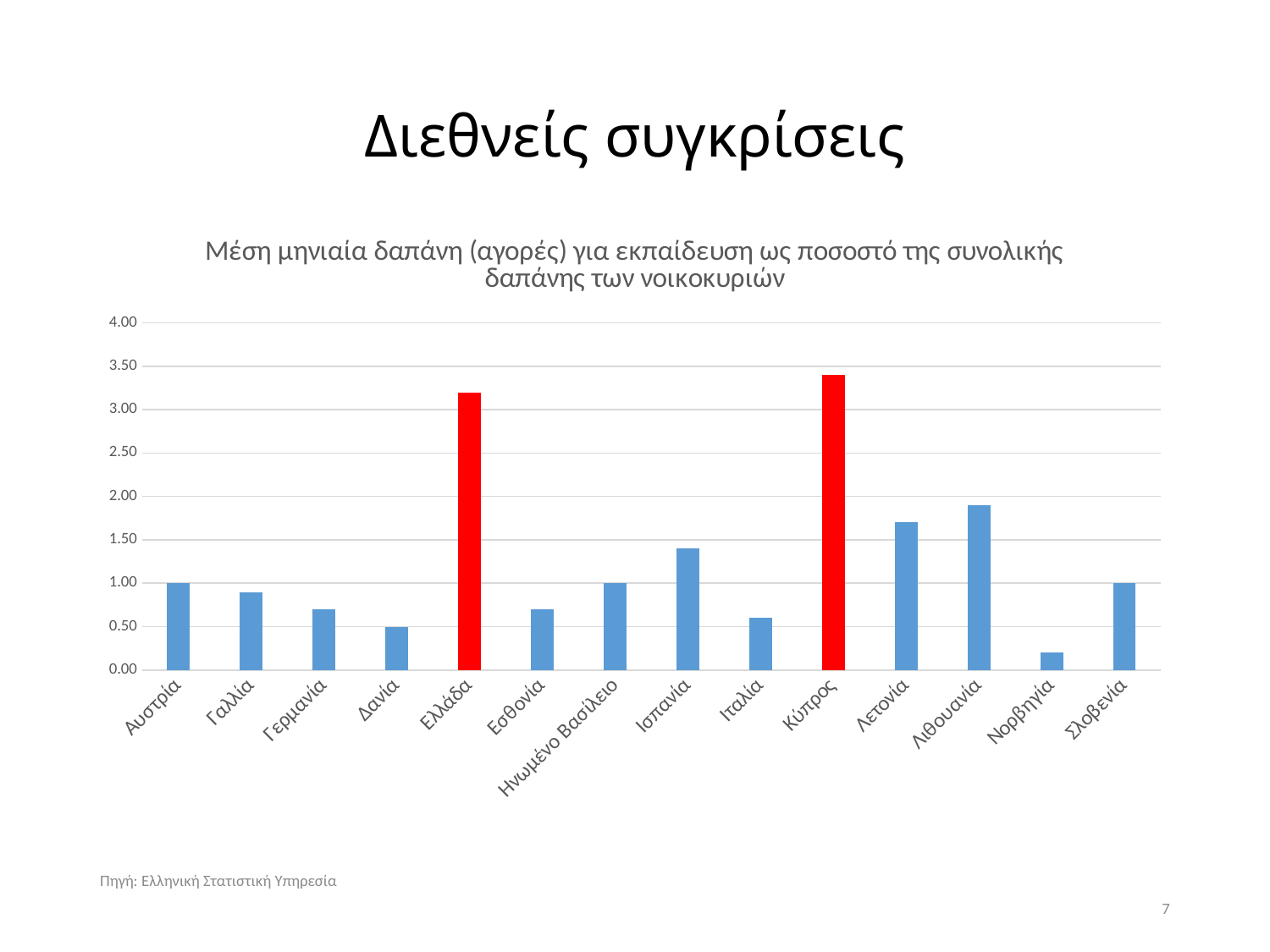
Is the value for Λιθουανία greater or less than 2.00? less What is the value for Δανία? 0.50 What is the value for Αυστρία? 1.00 Is the value for Ελλάδα greater or less than 3.00? greater What is the value for Σλοβενία? 1.00 Which two countries are shown with red bars? Ελλάδα and Κύπρος Is the value for Ισπανία greater or less than 1.00? greater Which country has the highest value in the chart? Κύπρος Which has the larger value, Λετονία or Ιταλία? Λετονία What kind of chart is shown on the slide? bar chart How many countries are shown on the x axis? 14 Which country has the lowest value in the chart? Νορβηγία